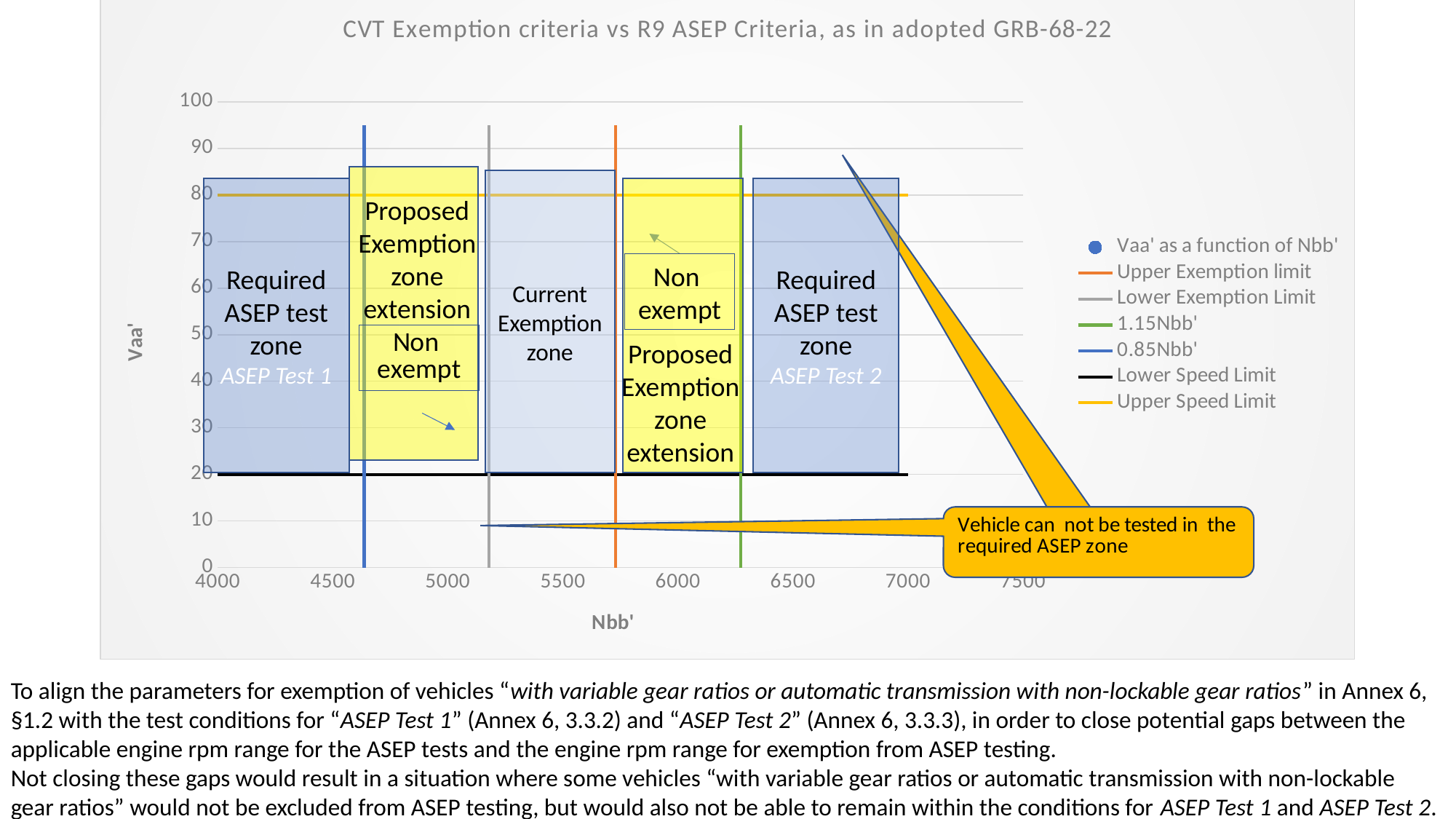
How many series does the chart legend list? 7 Which is higher on the Vaa' axis, the Upper Speed Limit or the Lower Speed Limit? Upper Speed Limit Is the Nbb' value of the Lower Exemption Limit line greater or less than 5500? less At what Vaa' value is the Lower Speed Limit line drawn? 20 What is the title of the chart? CVT Exemption criteria vs R9 ASEP Criteria, as in adopted GRB-68-22 How many vertical limit lines are drawn on the chart? 4 At what Vaa' value is the Upper Speed Limit line drawn? 80 Is the Nbb' value of the 0.85Nbb' line greater or less than 5000? less What colour is the Upper Exemption limit line in the legend? Orange Is the Nbb' value of the Upper Exemption limit line greater or less than 5500? greater What is the difference in Vaa' between the Upper Speed Limit and the Lower Speed Limit? 60